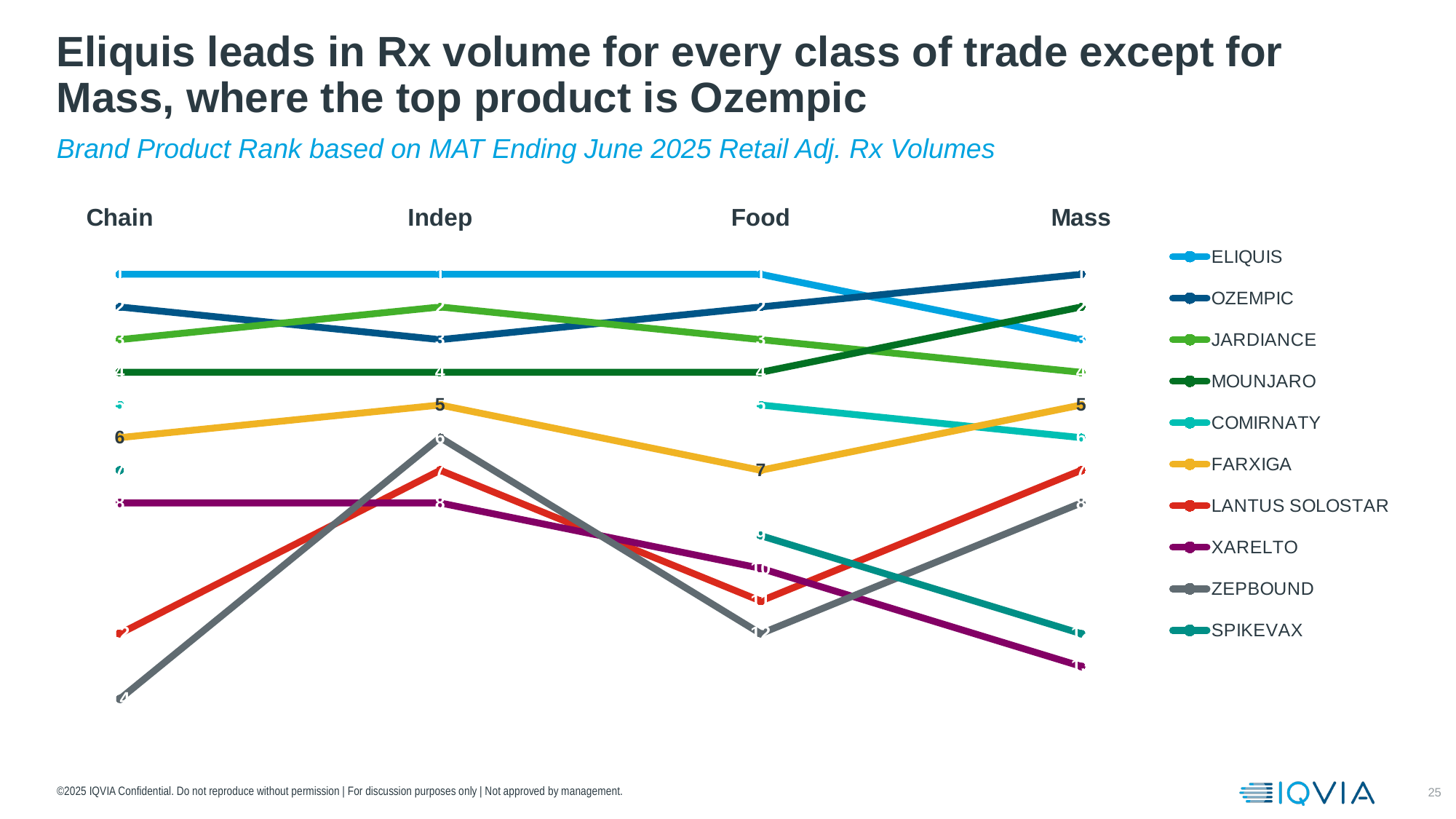
What is the rank of FARXIGA in the Mass class of trade? 5 How many series does the legend list? 10 What is the difference between FARXIGA's rank number in Food and in Indep? 2 What is the rank of FARXIGA in the Food class of trade? 7 What kind of chart is shown on the slide? line chart According to the slide, which product is the top product in the Mass class of trade? Ozempic How many classes of trade are shown along the x axis? 4 What is the first entry listed in the legend? ELIQUIS In which class of trade does FARXIGA have its largest rank number? Food Which is the larger rank number for FARXIGA: Chain or Indep? Chain What is the rank of FARXIGA in the Chain class of trade? 6 What is the rank of FARXIGA in the Indep class of trade? 5